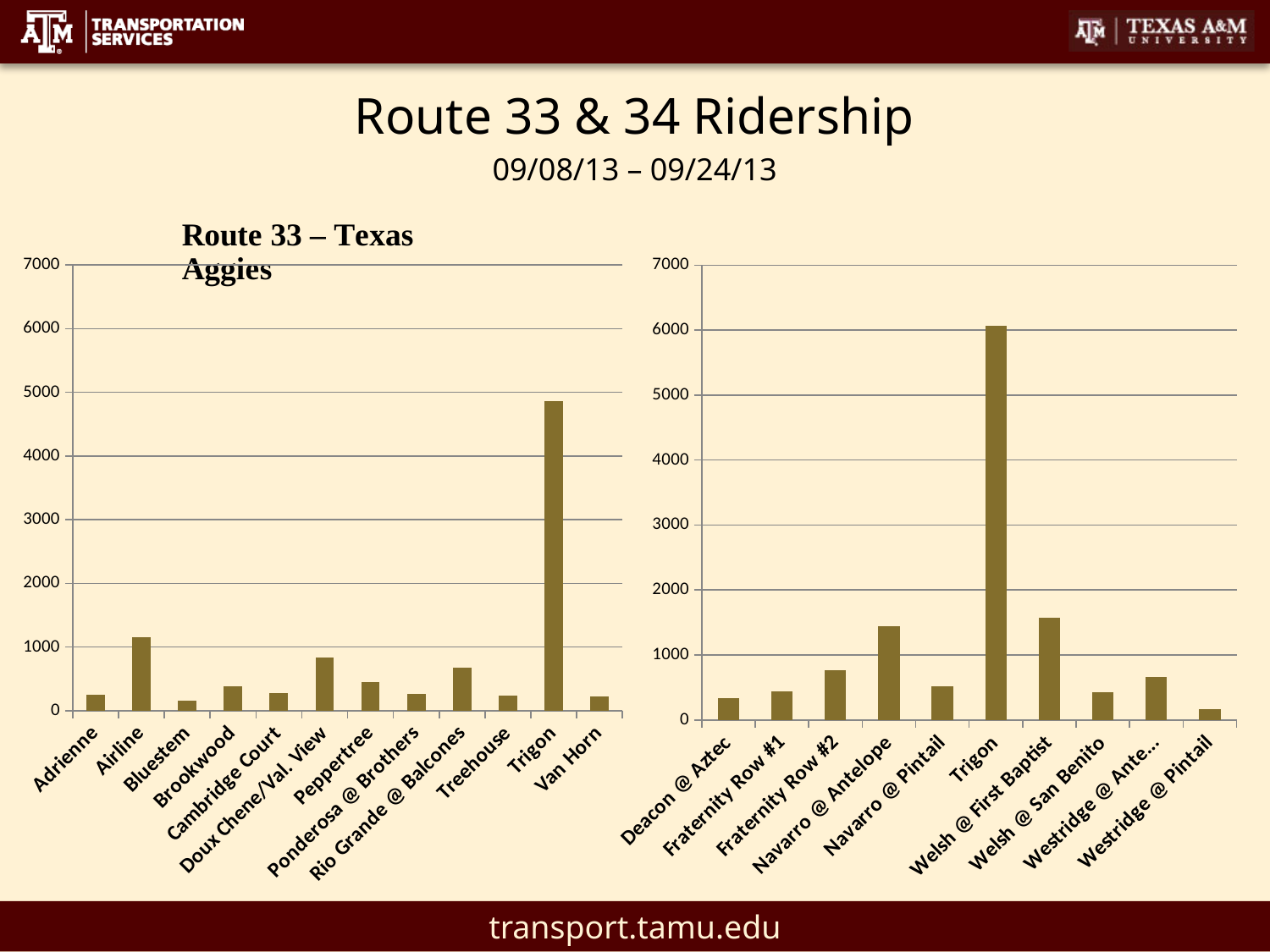
In the right chart, is the value for Fraternity Row #2 greater or less than 1000? less In the right chart, is the value for Trigon greater or less than 5000? greater In the left chart (Route 33 – Texas Aggies), which stop has the highest ridership? Trigon What kind of chart is the left chart, titled "Route 33 – Texas Aggies"? bar chart In the right chart, which stop has the highest ridership? Trigon Which chart shows the larger value for Trigon, the left chart or the right chart? the right chart In the left chart (Route 33 – Texas Aggies), is the value for Trigon greater or less than 4000? greater How many stops are shown on the x axis of the left chart (Route 33 – Texas Aggies)? 12 In the left chart (Route 33 – Texas Aggies), which has the larger value, Airline or Doux Chene/Val. View? Airline In the right chart, which stop has the lowest ridership? Westridge @ Pintail How many stops are shown on the x axis of the right chart? 10